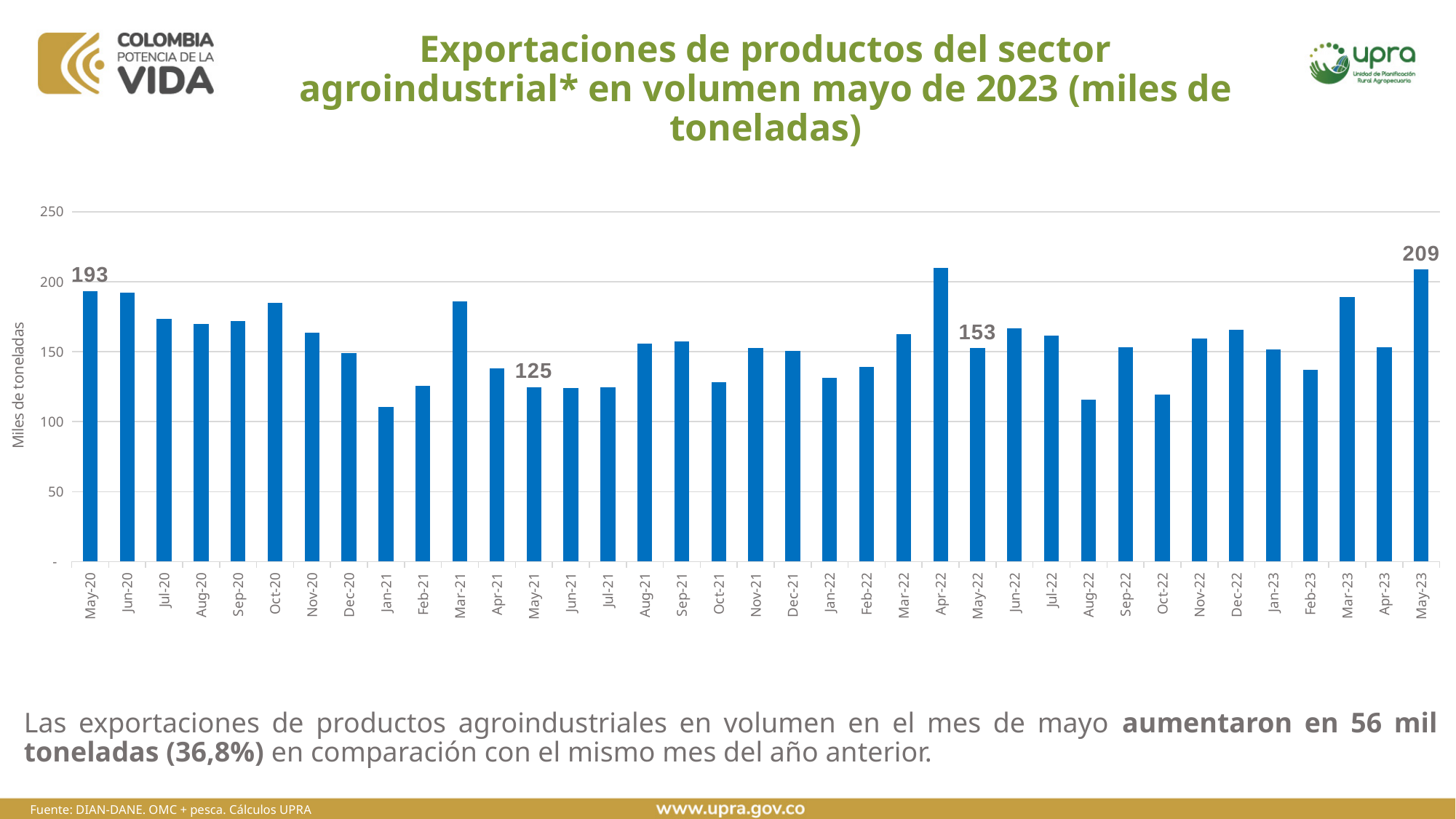
Is the value for Apr-22 greater or less than 200? greater What is the value for May-20? 193 What is the value for May-23? 209 What is the difference between the values for May-23 and May-22? 56 How many months are plotted in the chart? 37 What is the difference between the values for May-20 and May-21? 68 What is the value for May-22? 153 What is the value for May-21? 125 Which is larger, the value for May-23 or the value for May-20? May-23 What kind of chart is shown on the slide? Bar chart Is the value for Aug-22 greater or less than 150? less Which month has the lowest value in the chart? Jan-21